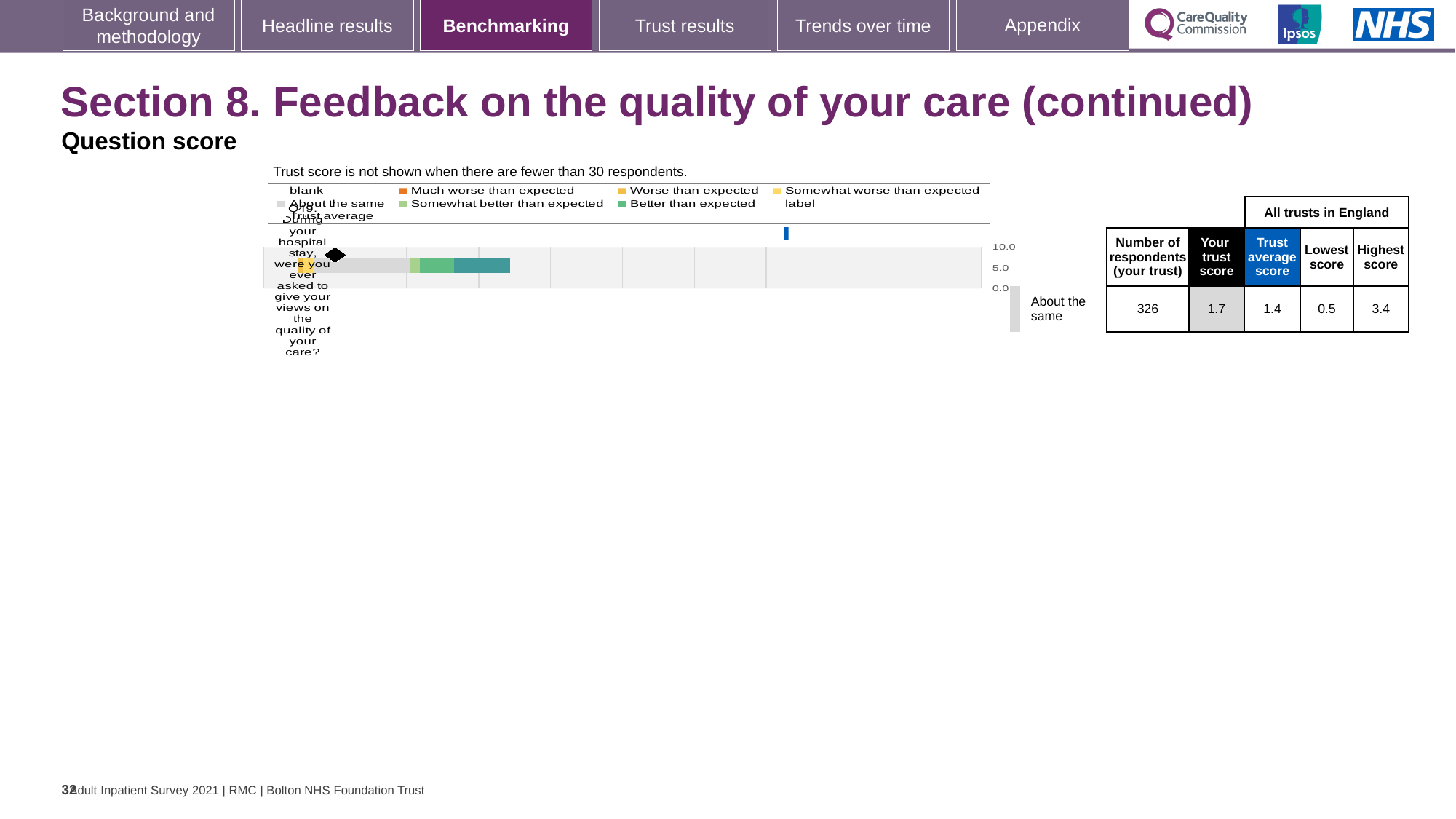
What colour does the legend use for "Much worse than expected"? orange What is the difference between the highest score (3.4) and the lowest score (0.5) in the table? 2.9 Is your trust score (1.7) larger or smaller than the trust average score (1.4)? larger In the table next to the chart, what is the highest score across all trusts in England? 3.4 In the table next to the chart, what is the number of respondents for your trust? 326 In the table next to the chart, what is the trust average score? 1.4 In the table next to the chart, what is your trust score? 1.7 Which question is plotted on the chart? Q49 What is the difference between your trust score (1.7) and the trust average score (1.4)? 0.3 In the table next to the chart, what is the lowest score across all trusts in England? 0.5 What benchmark category label is shown beside the chart for this question? About the same What kind of chart is shown on the slide? bar chart